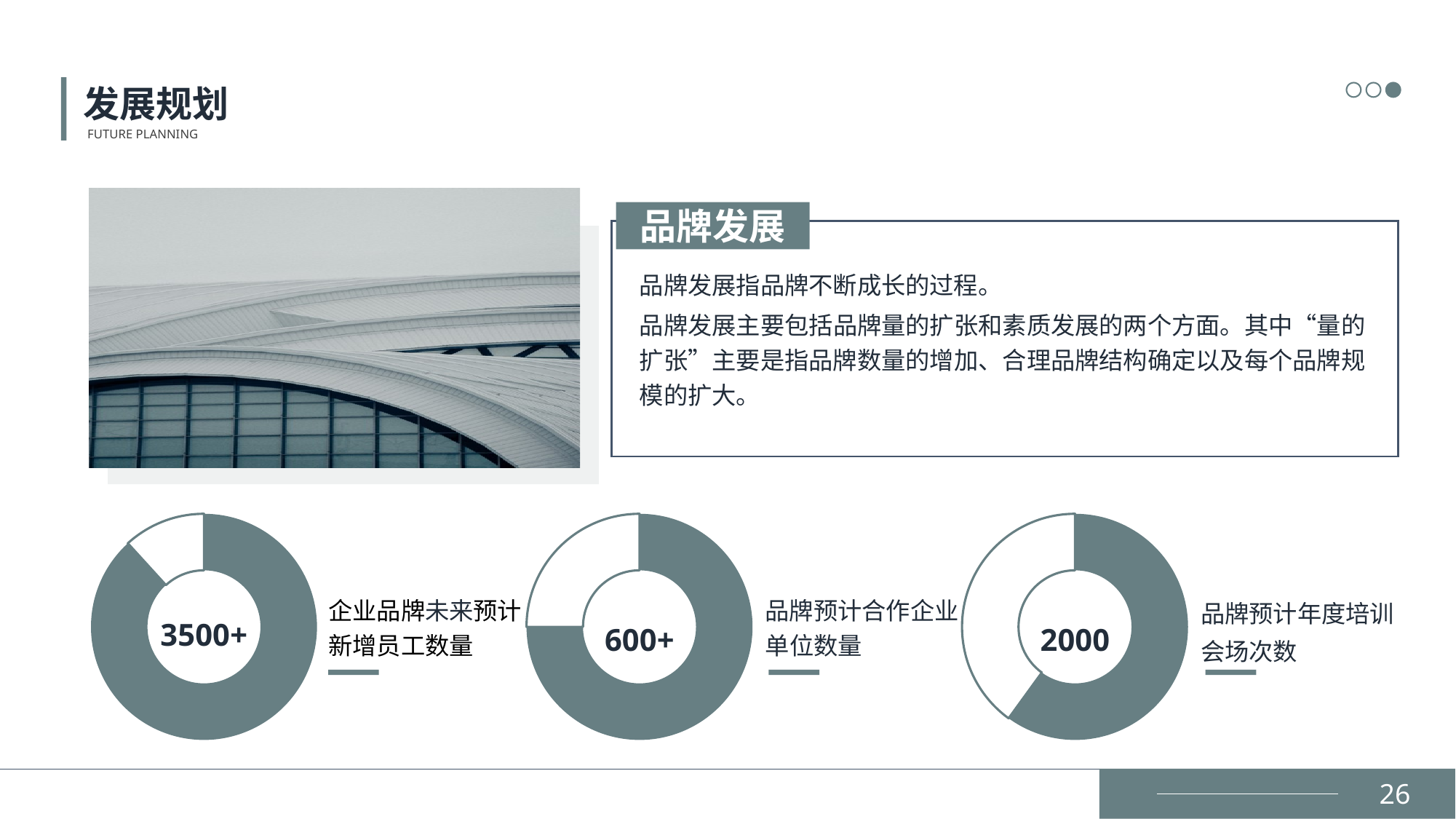
What value is shown in the centre of the middle donut chart labelled 品牌预计合作企业单位数量? 600+ What value is shown in the centre of the left donut chart labelled 企业品牌未来预计新增员工数量? 3500+ How many donut charts are shown on the slide? 3 What kind of chart is used for the three figures at the bottom of the slide? Donut chart Which of the three donut charts shows the largest centre value? The left one (3500+) Which donut chart has a larger shaded portion, the left one (3500+) or the right one (2000)? The left one (3500+) What value is shown in the centre of the right donut chart labelled 品牌预计年度培训会场次数? 2000 Which is larger, the centre value of the middle donut chart (品牌预计合作企业单位数量) or the right donut chart (品牌预计年度培训会场次数)? The right donut chart (2000) What label accompanies the donut chart showing 2000? 品牌预计年度培训会场次数 Which of the three donut charts shows the smallest centre value? The middle one (600+) What label accompanies the donut chart showing 600+? 品牌预计合作企业单位数量